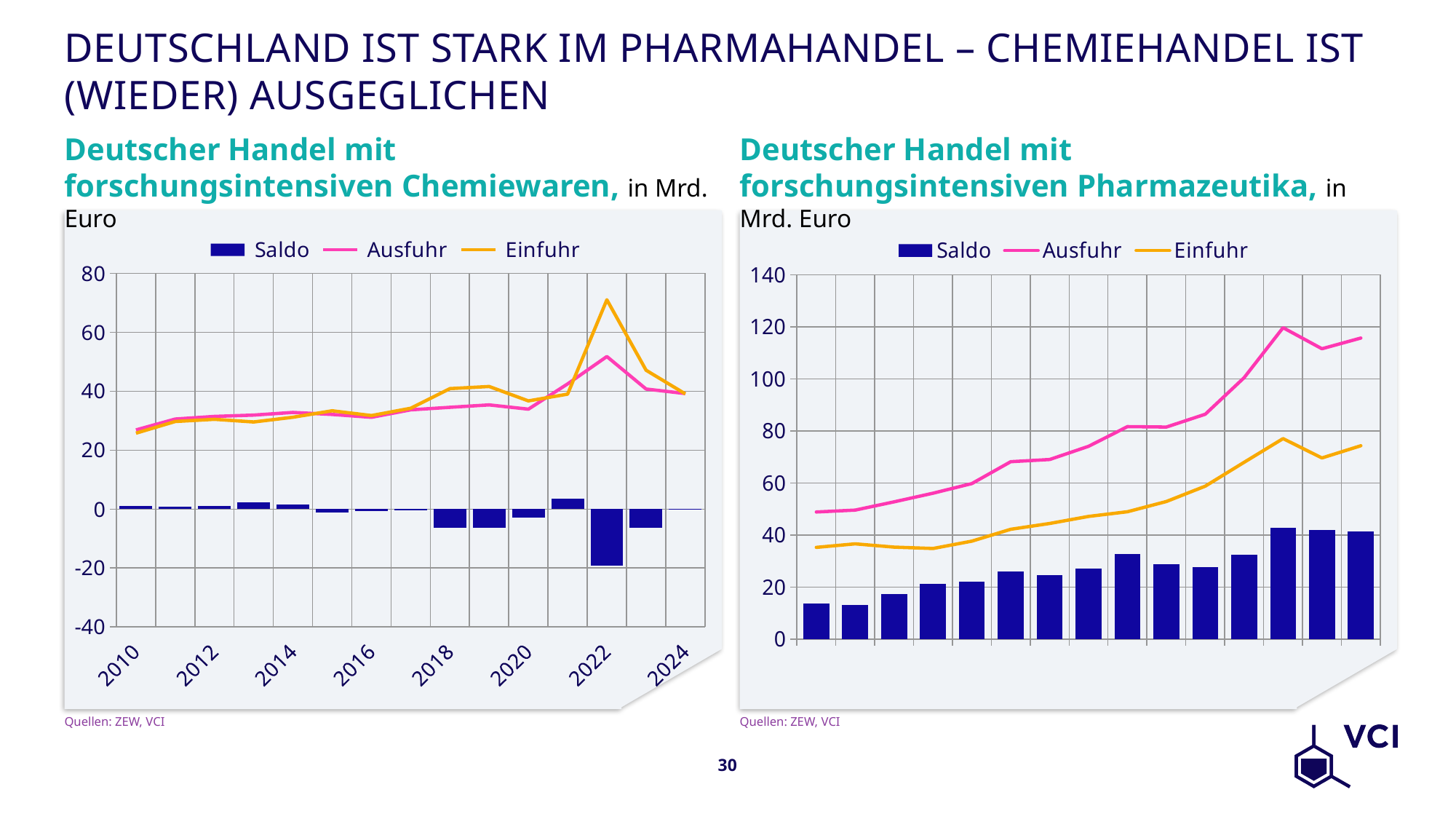
On the left chart (Chemiewaren), is the value for Saldo in 2022 greater or less than -10? less On the left chart (Chemiewaren), is the value for Ausfuhr in 2010 greater or less than 40? less On the left chart (Chemiewaren), what are the names of the series in the legend? Saldo, Ausfuhr, Einfuhr On the left chart (Chemiewaren), which is larger in 2022, Einfuhr or Ausfuhr? Einfuhr On the left chart (Chemiewaren), in which year does Einfuhr reach its highest value? 2022 On the right chart (Pharmazeutika), is the highest value of the Ausfuhr line greater or less than 100? greater On the right chart (Pharmazeutika), how many series does the legend list? 3 What kind of chart is the right chart (Pharmazeutika)? Combined bar and line chart On the left chart (Chemiewaren), how many series does the legend list? 3 On the right chart (Pharmazeutika), does the Ausfuhr line generally rise or fall from left to right? rise On the left chart (Chemiewaren), in which year is the Saldo bar lowest? 2022